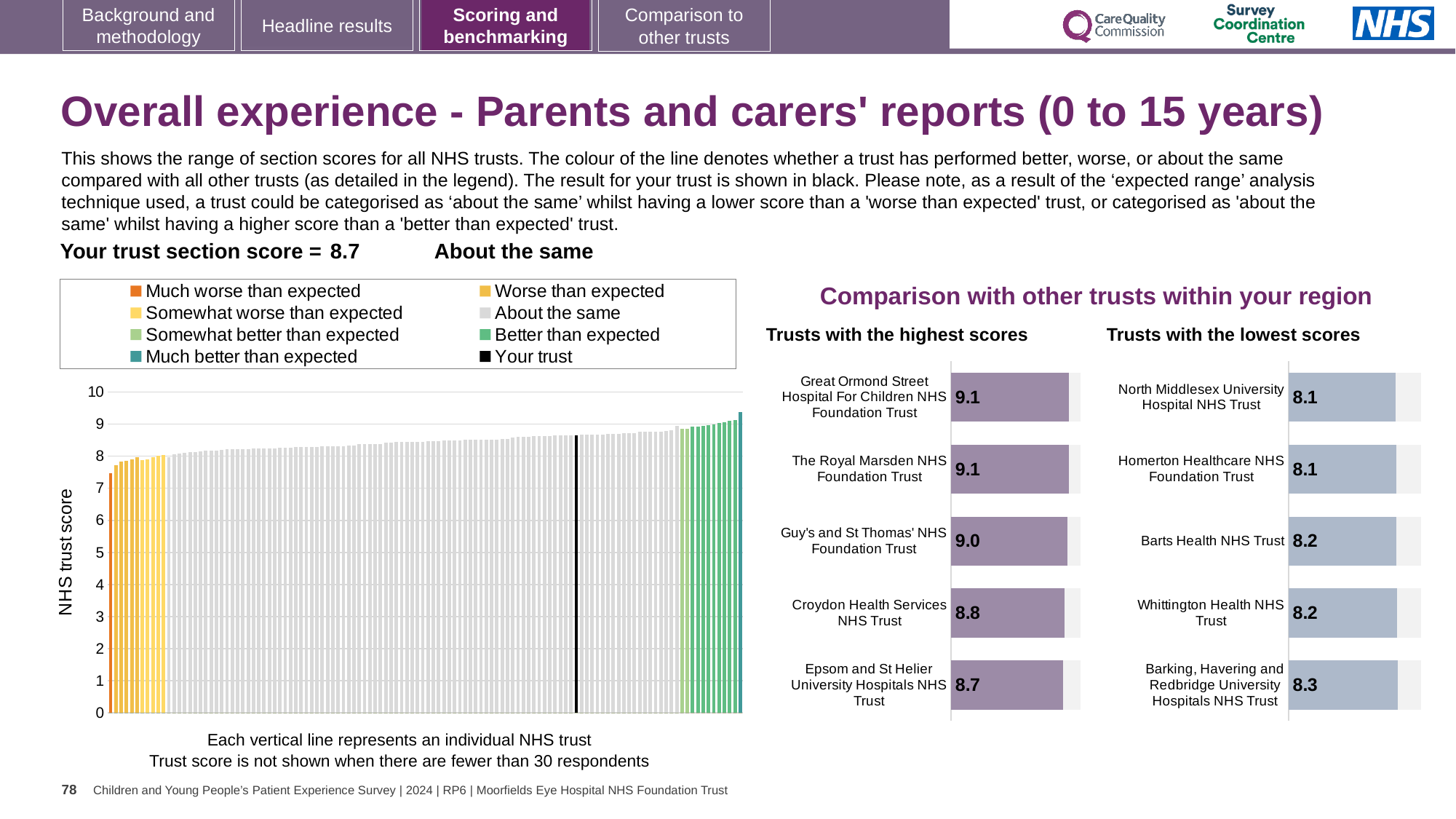
In the 'Trusts with the lowest scores' chart, what is the difference between the scores of Barking, Havering and Redbridge University Hospitals NHS Trust and North Middlesex University Hospital NHS Trust? 0.2 In the 'Trusts with the highest scores' chart, which trust has the lowest score? Epsom and St Helier University Hospitals NHS Trust In the 'Trusts with the lowest scores' chart, which trust has the highest score? Barking, Havering and Redbridge University Hospitals NHS Trust In the 'Trusts with the highest scores' chart, what is the difference between the scores of Great Ormond Street Hospital For Children NHS Foundation Trust and Epsom and St Helier University Hospitals NHS Trust? 0.4 How many trusts are listed in the 'Trusts with the lowest scores' chart? 5 In the 'Trusts with the highest scores' chart, what is the score for Guy's and St Thomas' NHS Foundation Trust? 9.0 In the large chart on the left, is the value of the black 'Your trust' bar greater or less than 8? greater In the 'Trusts with the highest scores' chart, what is the score for Croydon Health Services NHS Trust? 8.8 In the 'Trusts with the lowest scores' chart, what is the score for Barts Health NHS Trust? 8.2 Which has a higher score: Croydon Health Services NHS Trust in the 'highest scores' chart or Barts Health NHS Trust in the 'lowest scores' chart? Croydon Health Services NHS Trust In the large chart on the left, is the value of the leftmost (orange) bar greater or less than 8? less What kind of chart is the large chart on the left showing NHS trust scores? bar chart